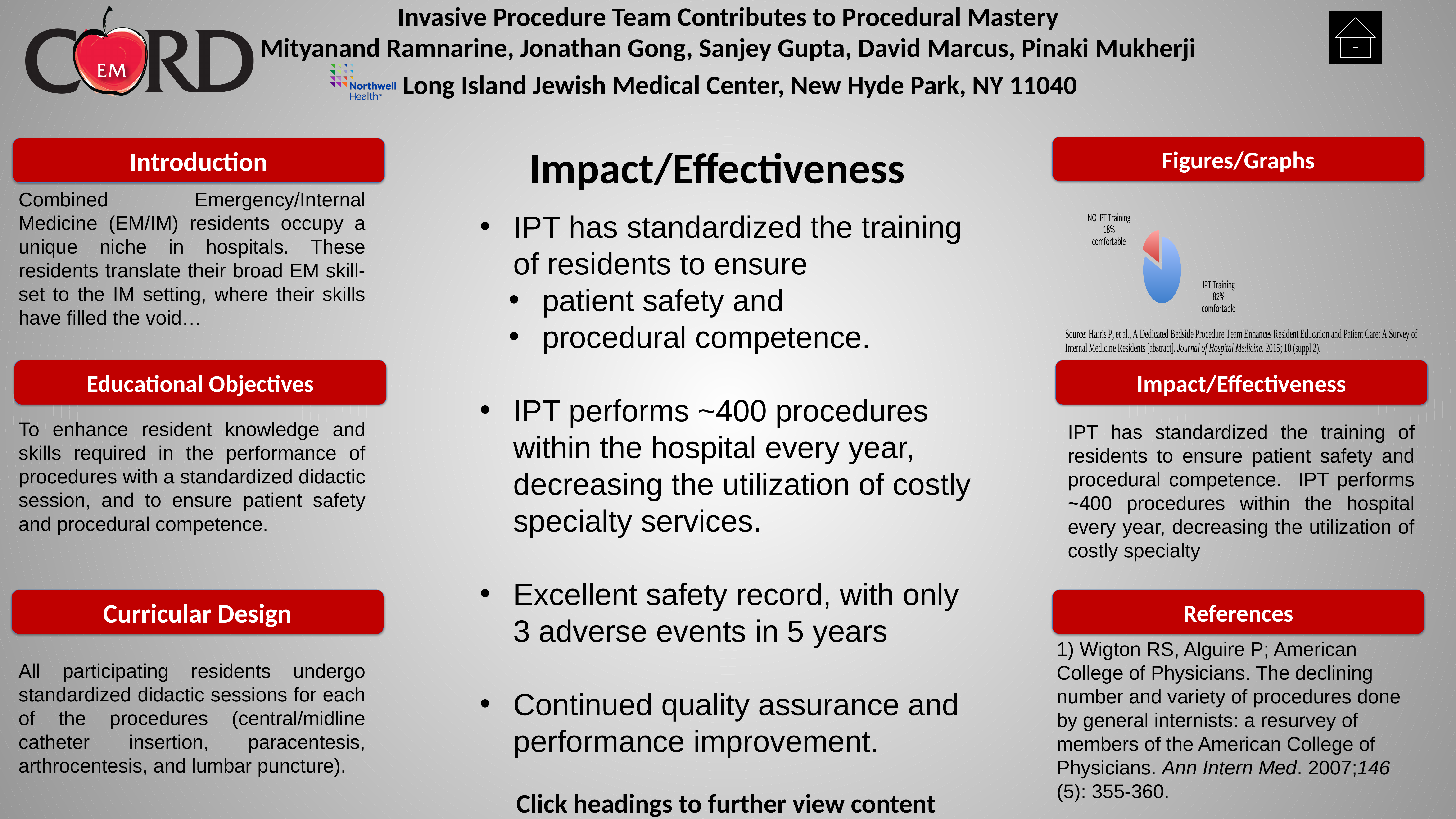
What share of the pie chart does the IPT Training slice represent? 82% Which slice of the pie chart is the largest? IPT Training In the pie chart, which is larger: IPT Training or NO IPT Training? IPT Training What colour is the NO IPT Training slice in the pie chart? red How many slices does the pie chart have? 2 What percentage is shown for the NO IPT Training slice of the pie chart? 18% What colour is the IPT Training slice in the pie chart? blue What kind of chart is shown in the Figures/Graphs section? pie chart What percentage is shown for the IPT Training slice of the pie chart? 82% Which slice of the pie chart is the smallest? NO IPT Training What is the difference in percentage points between the IPT Training and NO IPT Training slices of the pie chart? 64